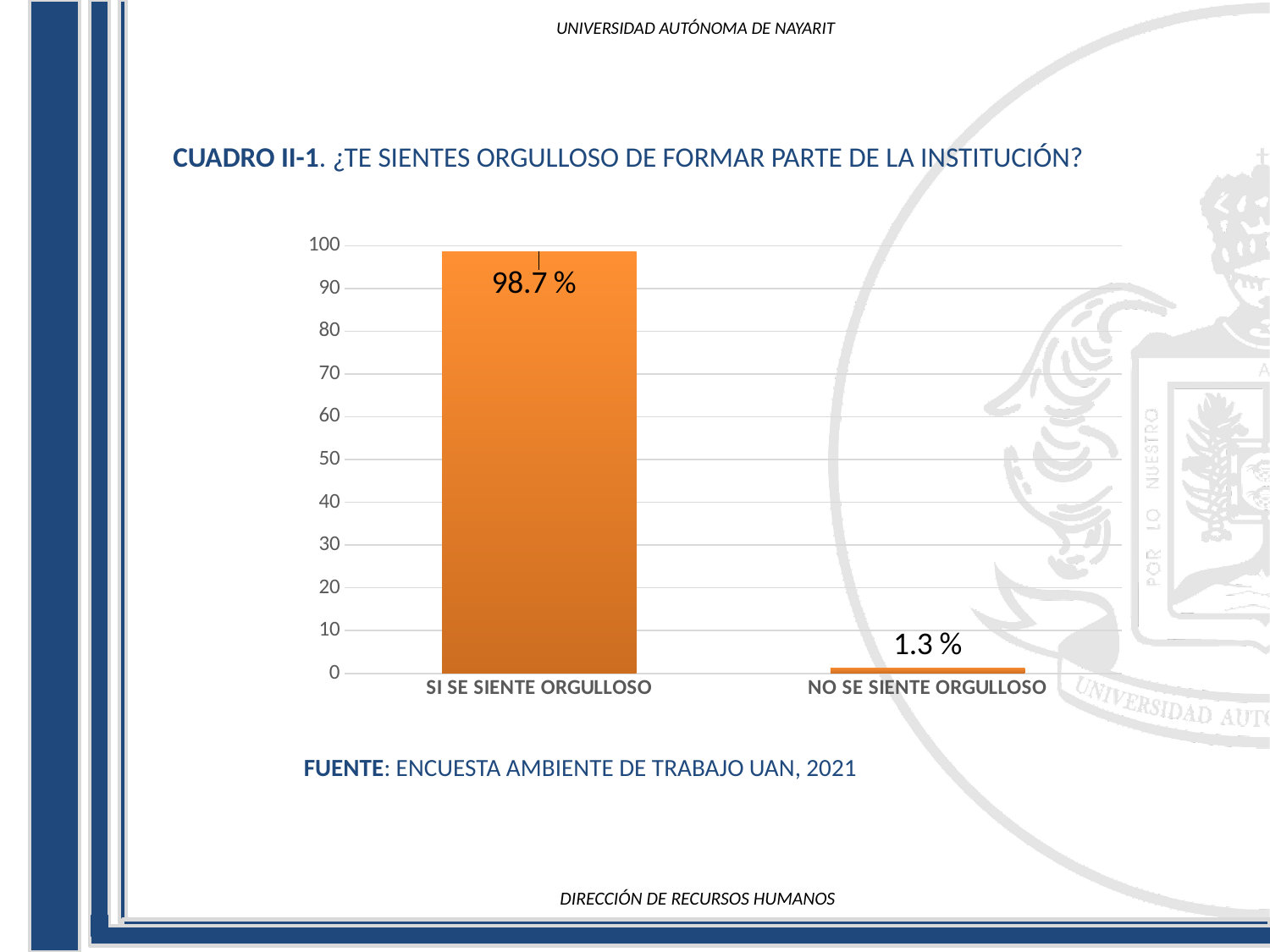
What is the value for NO SE SIENTE ORGULLOSO? 1.3 % What source is cited below the chart? ENCUESTA AMBIENTE DE TRABAJO UAN, 2021 Is the value for NO SE SIENTE ORGULLOSO greater or less than 10? less How many categories are shown on the chart? 2 Is the value for SI SE SIENTE ORGULLOSO greater or less than 90? greater Which category has the highest value? SI SE SIENTE ORGULLOSO What kind of chart is shown on the slide? bar chart Which category has the lowest value? NO SE SIENTE ORGULLOSO Which is larger, the value for SI SE SIENTE ORGULLOSO or NO SE SIENTE ORGULLOSO? SI SE SIENTE ORGULLOSO What is the title of the chart? CUADRO II-1. ¿TE SIENTES ORGULLOSO DE FORMAR PARTE DE LA INSTITUCIÓN? What is the value for SI SE SIENTE ORGULLOSO? 98.7 % What is the difference between the values for SI SE SIENTE ORGULLOSO and NO SE SIENTE ORGULLOSO? 97.4 %